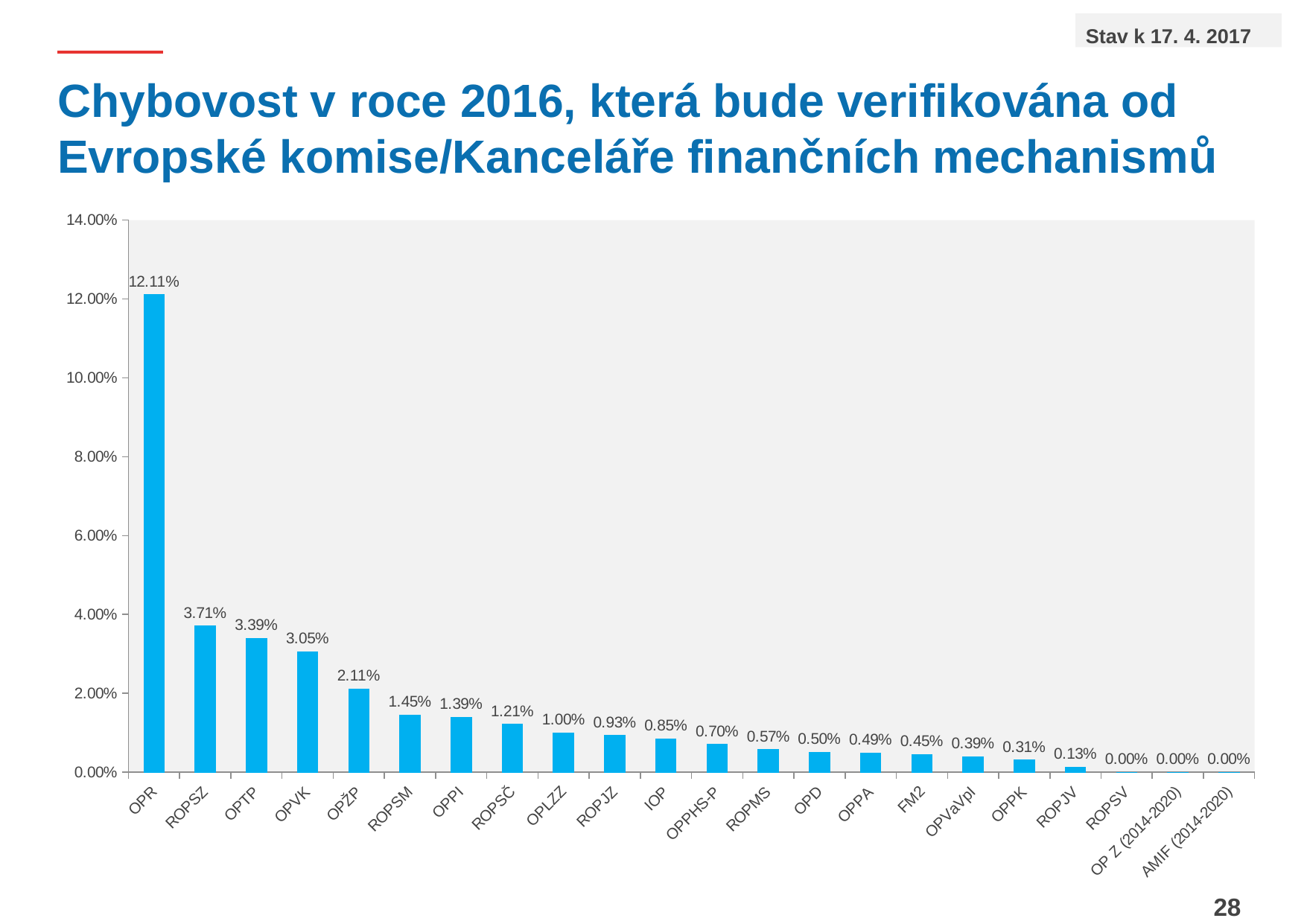
What is the value for ROPJV? 0.13% How many categories are shown on the x axis? 22 Is the value for OPR greater or less than 10.00%? greater What is the difference between the values for OPTP and OPVK? 0.34% What kind of chart is shown on the slide? bar chart What is the difference between the values for OPR and ROPSZ? 8.40% What is the value for OPVaVpI? 0.39% How many categories have a value of 0.00%? 3 What is the value for OPŽP? 2.11% Which is larger, the value for ROPSM or the value for OPPI? ROPSM What is the value for OPR? 12.11% Which category has the highest value? OPR